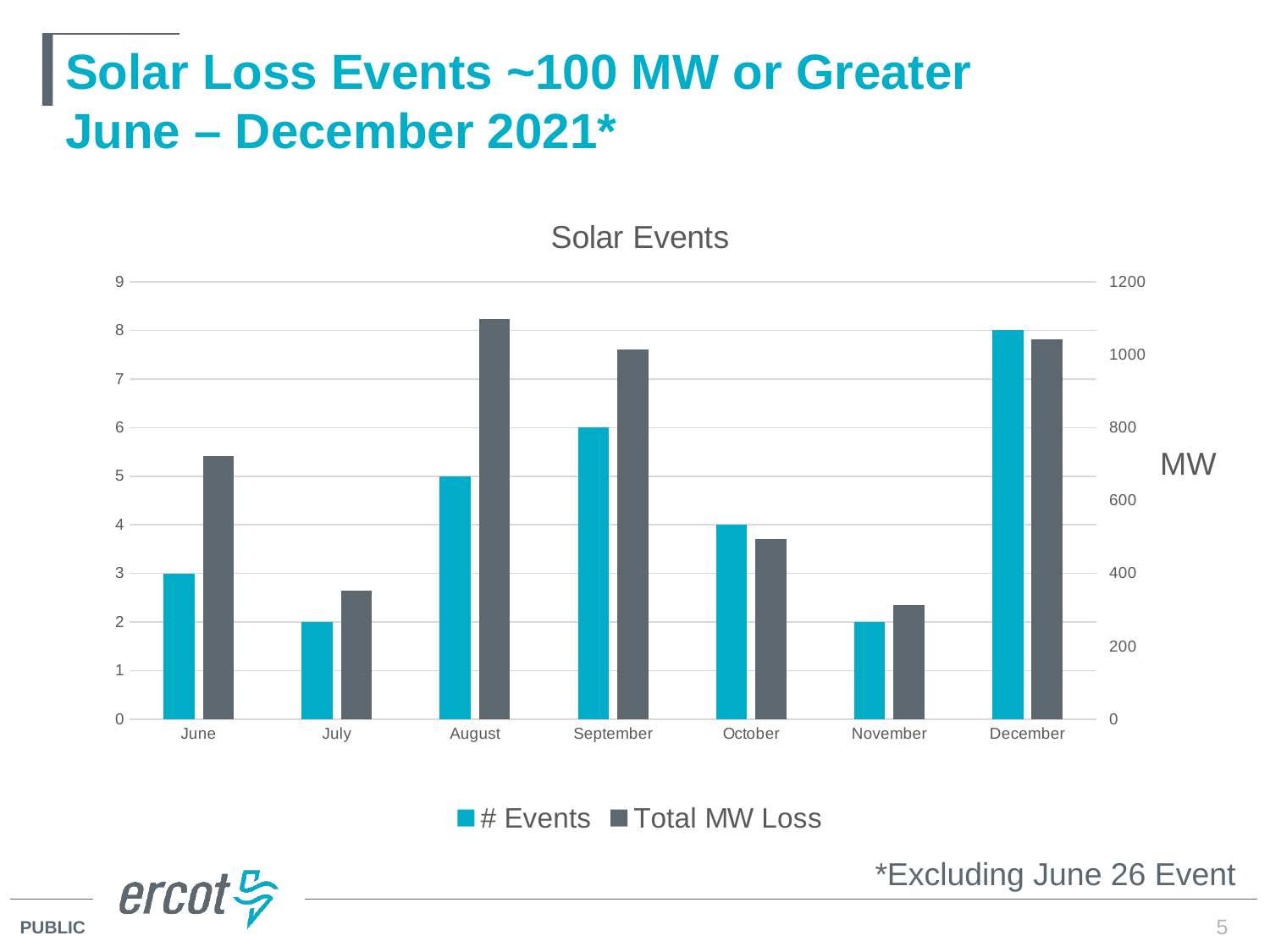
What type of chart is shown on the slide? Bar chart Which month has more events, September or October? September What is the number of events for September? 6 What is the difference in number of events between December and June? 5 Is the Total MW Loss for August greater or less than 1000? greater Is the Total MW Loss for July greater or less than 400? less How many months are shown on the x axis? 7 How many events are shown for December? 8 How many series does the legend list? 2 Which month has the highest Total MW Loss? August What is the number of events for August? 5 Which month has the highest number of events? December